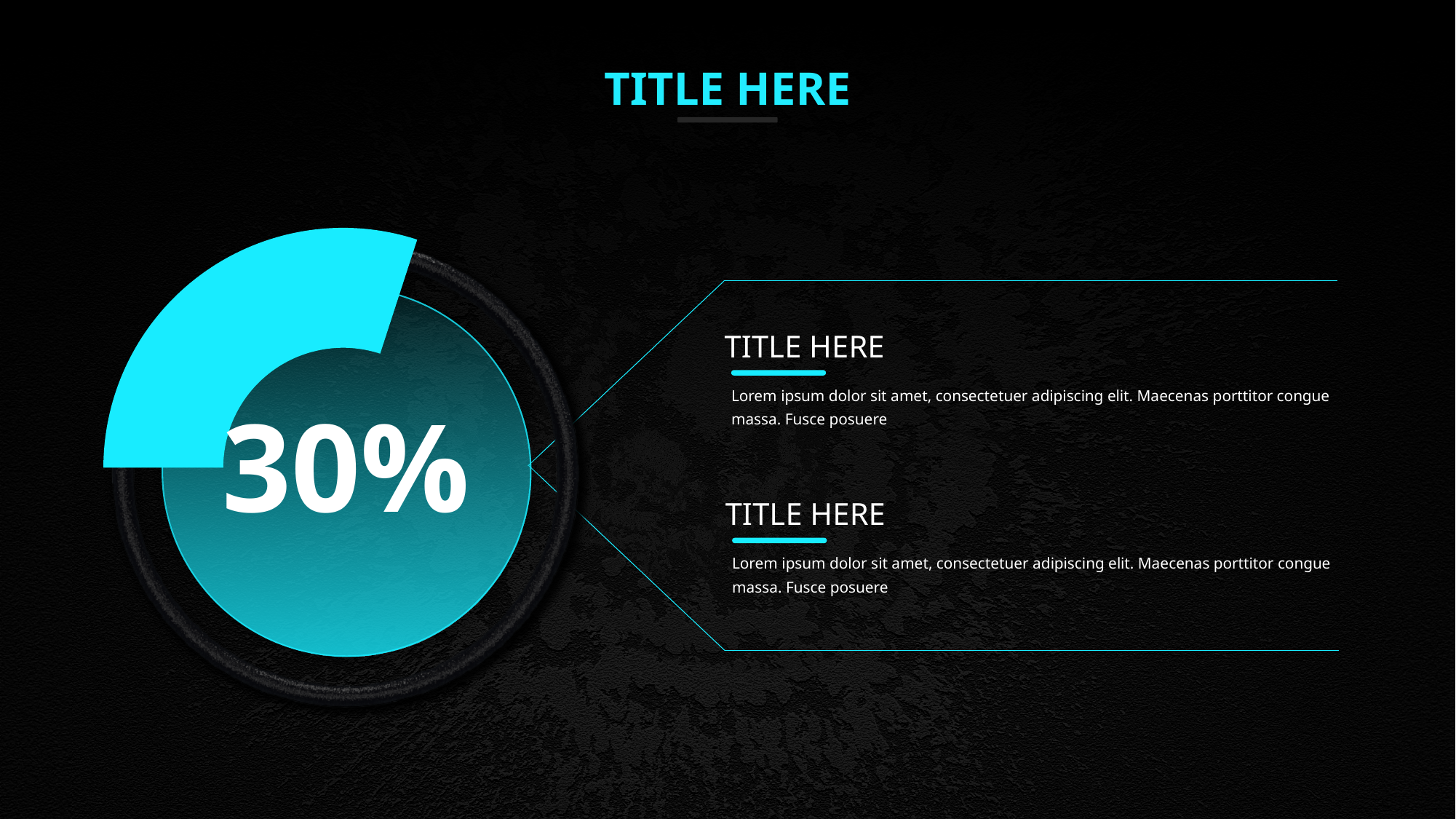
What percentage value is printed in the centre of the pie chart? 30% What share of the pie does the highlighted cyan slice represent? 30% What is the title printed at the top of the slide? TITLE HERE What colour is the highlighted slice of the pie chart? cyan What share of the pie is not covered by the highlighted slice? 70% Is the highlighted slice of the pie chart larger or smaller than the remaining portion? smaller Is the highlighted slice of the pie chart greater or less than 50%? less What kind of chart is shown on the left of the slide? doughnut chart